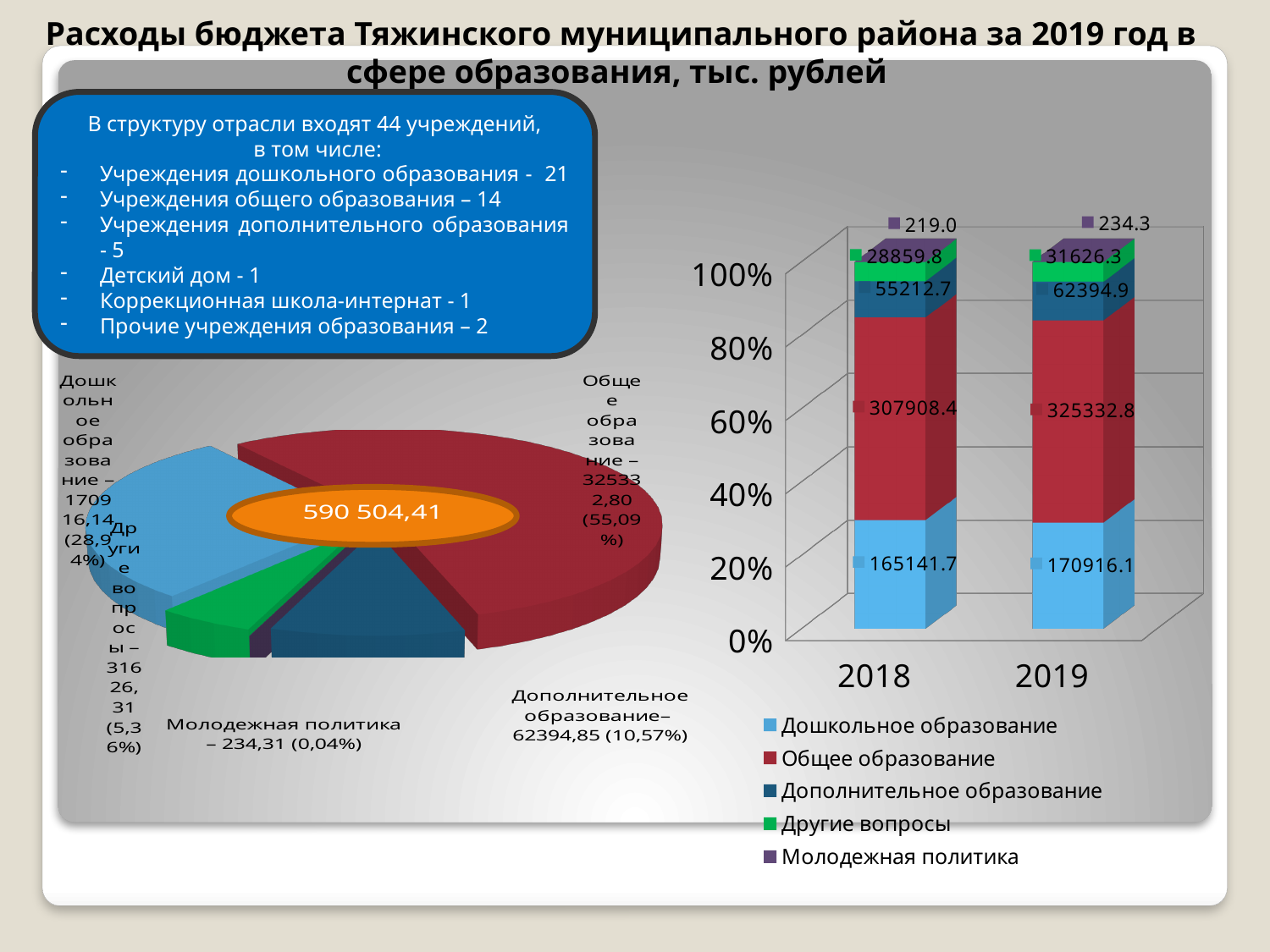
In the pie chart on the left, which category has the smallest share? Молодежная политика In the stacked bar chart on the right, how many years are shown on the x axis? 2 What kind of chart is shown on the left of the slide? pie chart In the stacked bar chart on the right, what is the value for Другие вопросы in 2018? 28859.8 In the pie chart on the left, what share does Общее образование have? 55,09% In the stacked bar chart on the right, what is the value for Дошкольное образование in 2018? 165141.7 In the stacked bar chart on the right, which is larger: Дополнительное образование in 2018 or in 2019? 2019 In the stacked bar chart on the right, how many series does the legend list? 5 In the stacked bar chart on the right, what is the value for Общее образование in 2019? 325332.8 In the stacked bar chart on the right, what is the value for Молодежная политика in 2019? 234.3 In the stacked bar chart on the right, what is the difference between Дошкольное образование in 2019 and in 2018? 5774.4 In the stacked bar chart on the right, does the value for Общее образование rise or fall from 2018 to 2019? rise